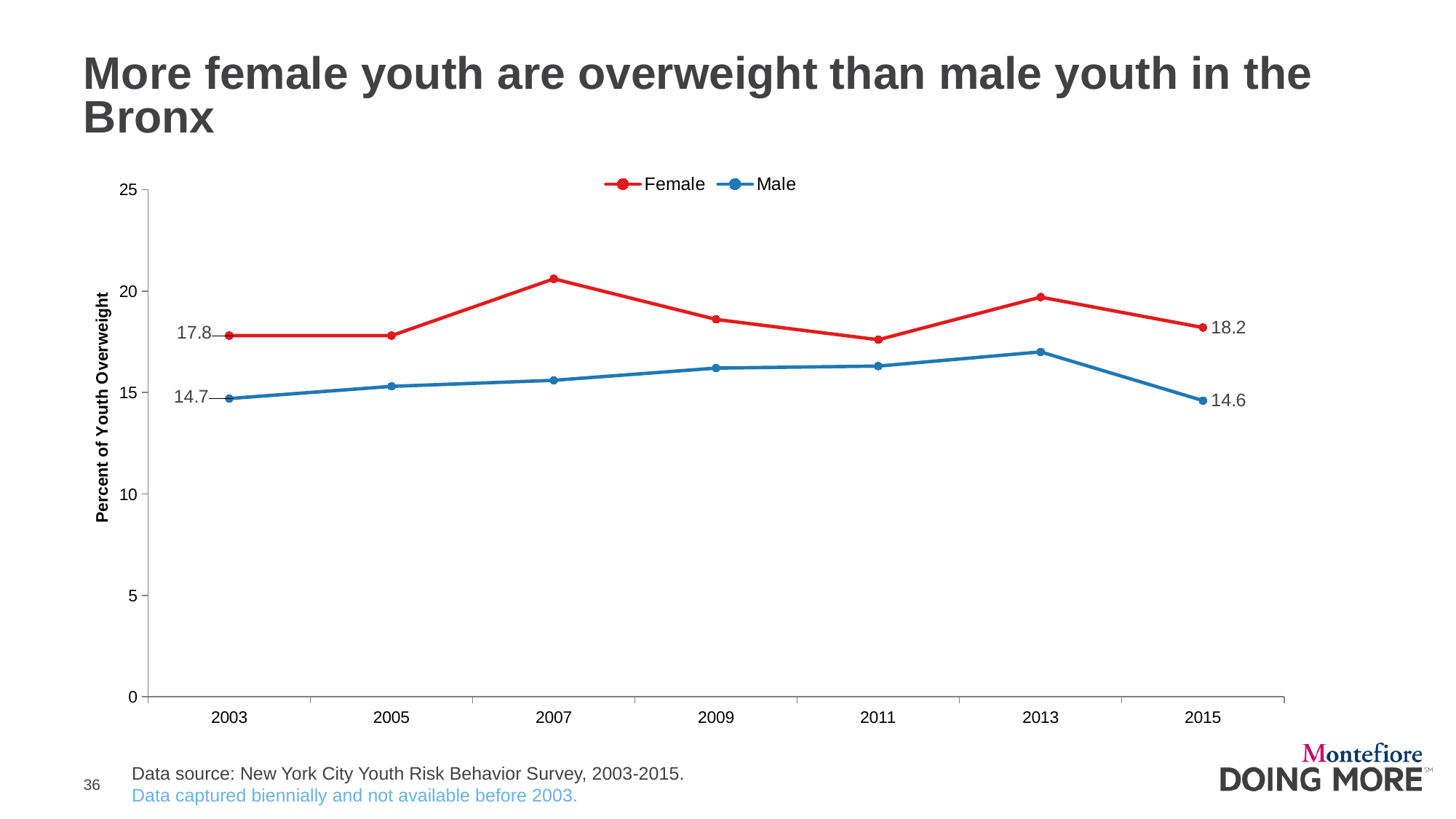
In which year is the Female value highest? 2007 In which year is the Male value highest? 2013 What kind of chart is shown on the slide? Line chart What is the Female value in 2015? 18.2 Which series has the larger value in 2011, Female or Male? Female What is the difference between the Female and Male values in 2003? 3.1 What is the Female value in 2003? 17.8 What is the Male value in 2003? 14.7 What is the Male value in 2015? 14.6 Is the Female value in 2007 greater or less than 20? greater What is the difference between the Female and Male values in 2015? 3.6 How many series does the legend list? 2